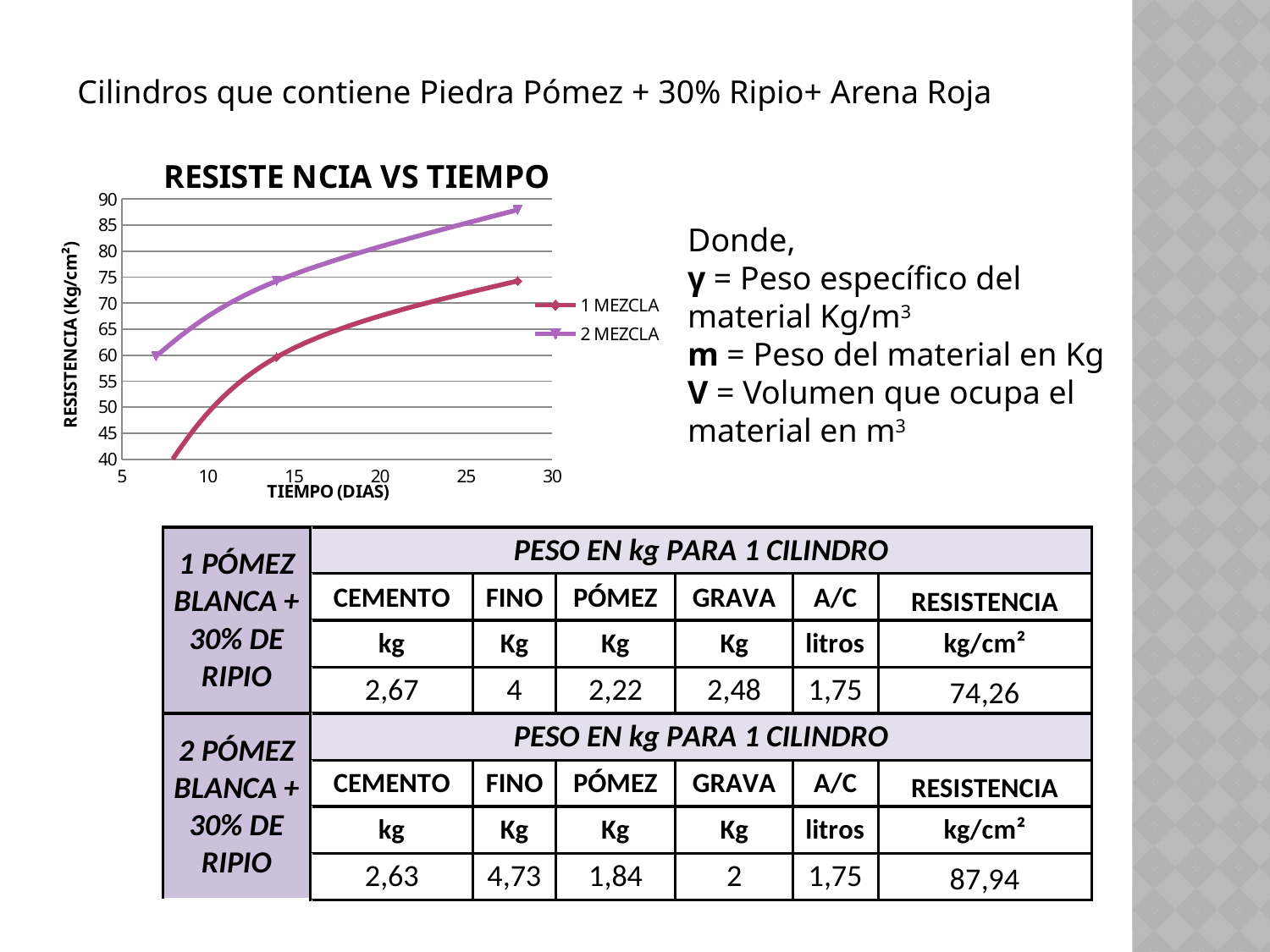
What kind of chart is shown on the slide? line chart Is the value of the 2 MEZCLA series at its middle point (around 14 days) greater or less than 70? greater What is the label of the vertical axis of the chart? RESISTENCIA (Kg/cm²) Is the value of the 1 MEZCLA series at its middle point (around 14 days) greater or less than 65? less How many series does the chart legend list? 2 Which series has the lower RESISTENCIA across the whole chart, 1 MEZCLA or 2 MEZCLA? 1 MEZCLA At the right end of the chart (around 28 days), which series has the higher RESISTENCIA, 1 MEZCLA or 2 MEZCLA? 2 MEZCLA Is the value of the 2 MEZCLA series at its last point (around 28 days) greater or less than 85? greater What is the title of the chart? RESISTE NCIA VS TIEMPO Do the values of the 2 MEZCLA series rise or fall as TIEMPO (DIAS) increases? rise Do the values of the 1 MEZCLA series rise or fall as TIEMPO (DIAS) increases? rise